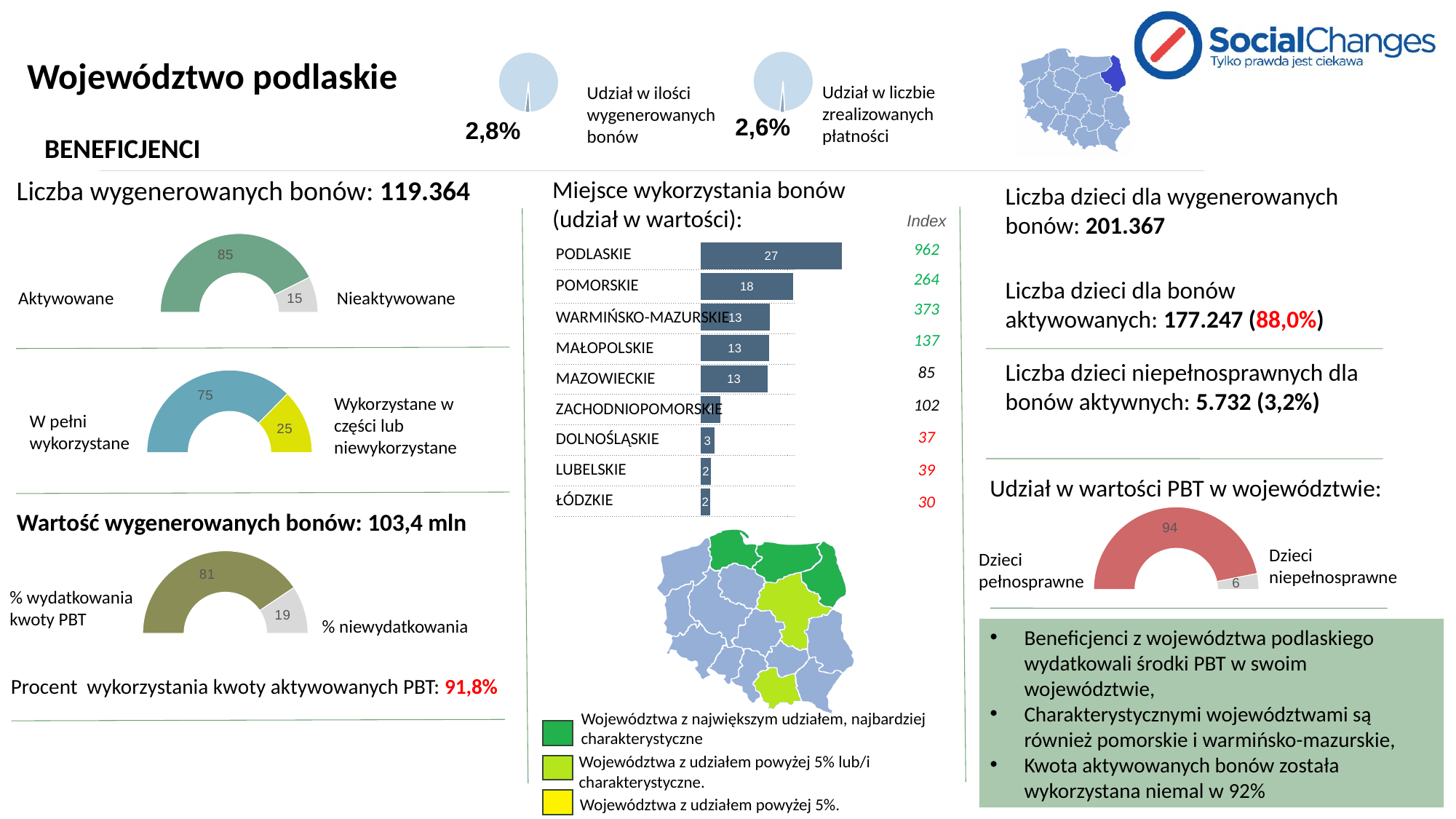
How many voivodeships are listed in the bar chart 'Miejsce wykorzystania bonów (udział w wartości)'? 9 In the half-donut chart 'Udział w wartości PBT w województwie', what is the value for 'Dzieci niepełnosprawne'? 6 In the bar chart 'Miejsce wykorzystania bonów (udział w wartości)', which voivodeship has the highest value? PODLASKIE In the bar chart 'Miejsce wykorzystania bonów (udział w wartości)', what is the value for PODLASKIE? 27 In the 'Miejsce wykorzystania bonów' chart, what is the Index value shown for PODLASKIE? 962 In the bar chart 'Miejsce wykorzystania bonów (udział w wartości)', which is larger, POMORSKIE or MAŁOPOLSKIE? POMORSKIE In the bar chart 'Miejsce wykorzystania bonów (udział w wartości)', what is the difference between the values for PODLASKIE and POMORSKIE? 9 In the half-donut chart under 'Wartość wygenerowanych bonów', what is the value for '% niewydatkowania'? 19 In the half-donut chart with 'W pełni wykorzystane', what is the value for 'W pełni wykorzystane'? 75 In the half-donut chart under 'Liczba wygenerowanych bonów', what is the value for Aktywowane? 85 What kind of chart is 'Miejsce wykorzystania bonów (udział w wartości)'? bar chart In the small pie chart at the top labelled 'Udział w ilości wygenerowanych bonów', what percentage is shown? 2,8%